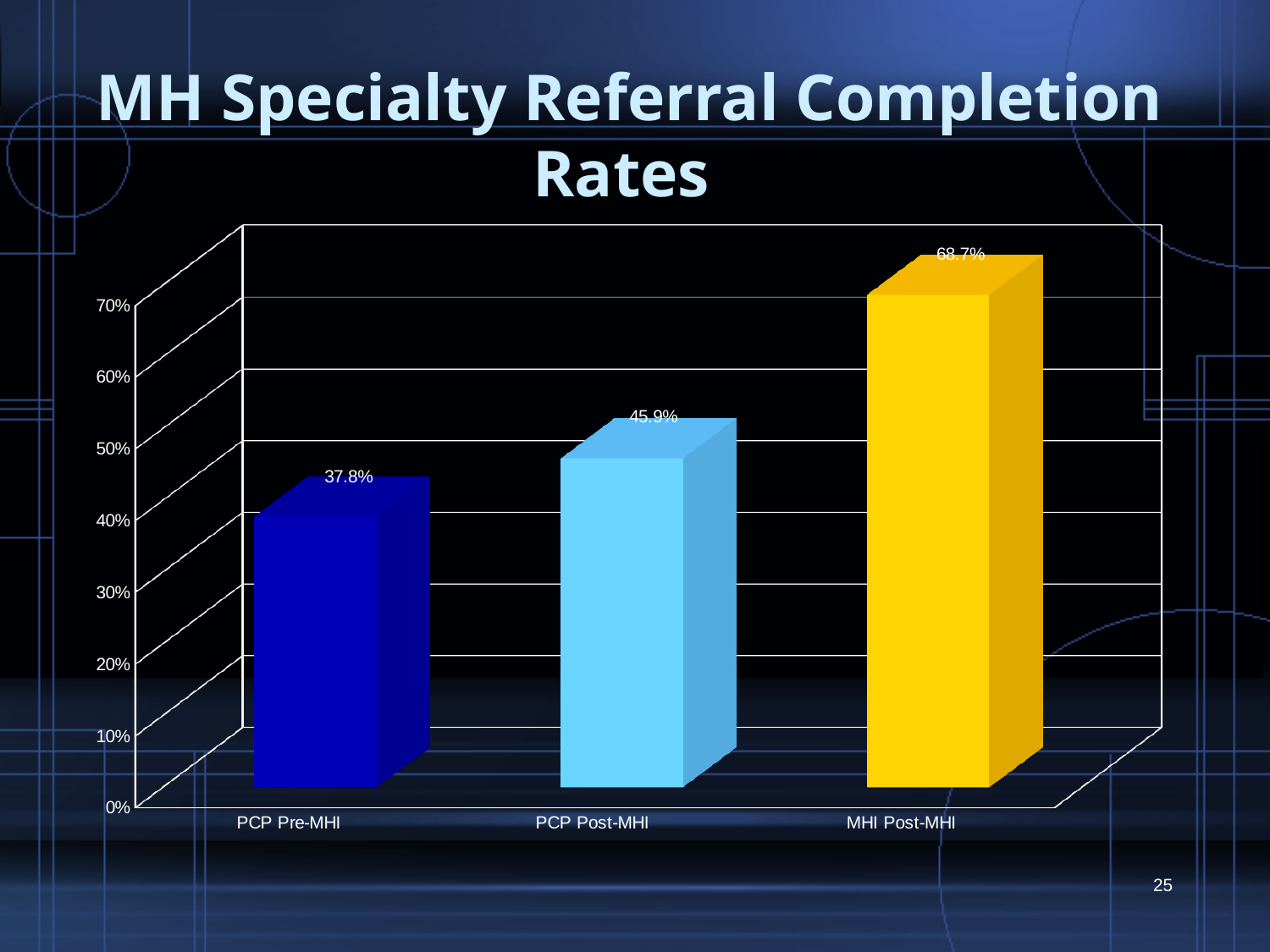
What is the difference between the PCP Post-MHI rate and the PCP Pre-MHI rate? 8.1% Which category has the highest referral completion rate? MHI Post-MHI What is the difference between the MHI Post-MHI rate and the PCP Post-MHI rate? 22.8% What is the referral completion rate for MHI Post-MHI? 68.7% What is the referral completion rate for PCP Pre-MHI? 37.8% Which is larger, the rate for PCP Pre-MHI or the rate for PCP Post-MHI? PCP Post-MHI How many categories are shown in the chart? 3 Which category has the lowest referral completion rate? PCP Pre-MHI What is the referral completion rate for PCP Post-MHI? 45.9% What kind of chart is shown on the slide? Bar chart What is the title of the chart on the slide? MH Specialty Referral Completion Rates Is the value for MHI Post-MHI greater or less than 60%? greater